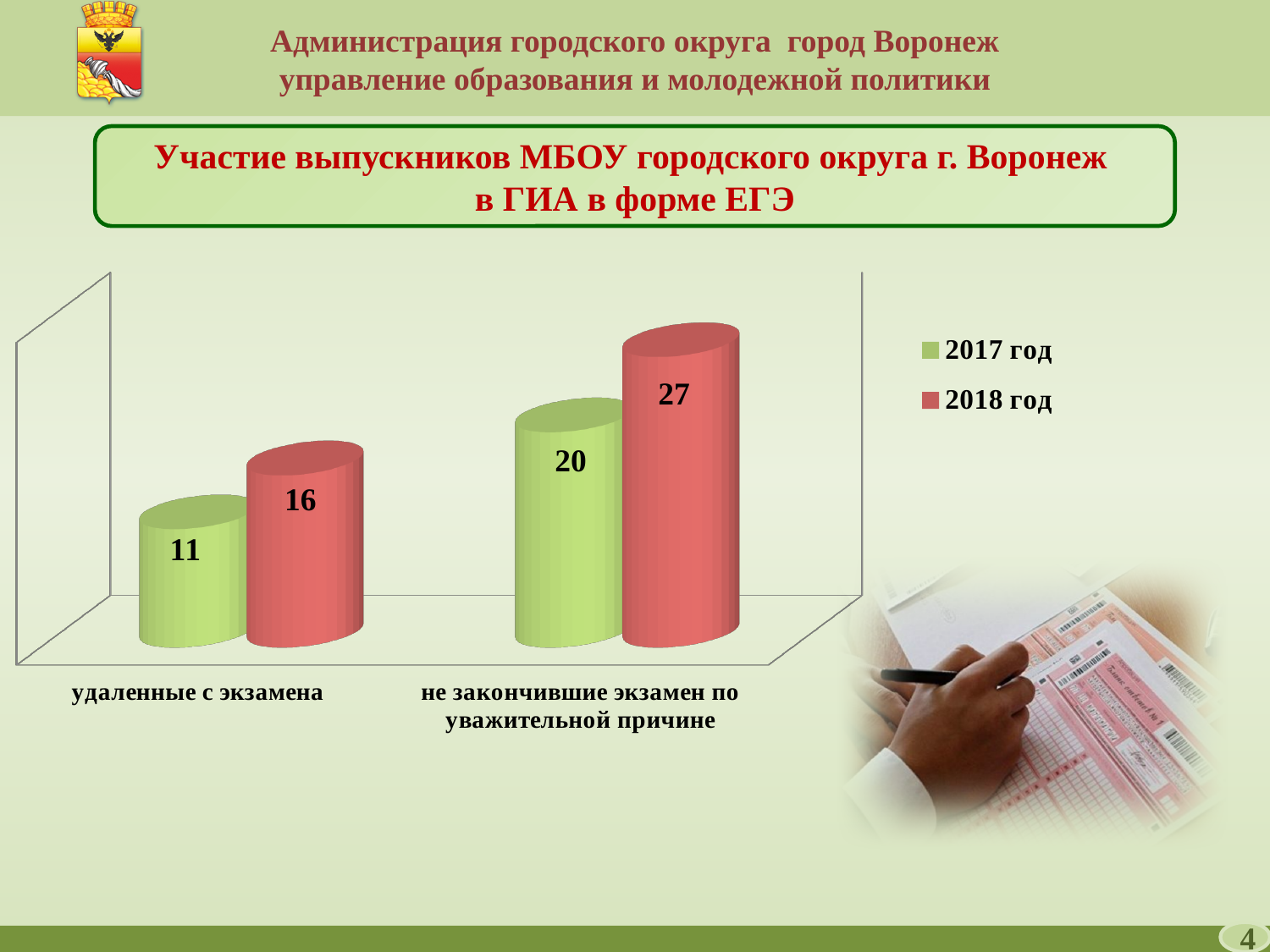
What is the value for 2018 год in the category 'не закончившие экзамен по уважительной причине'? 27 What kind of chart is shown on the slide? bar chart How many series does the legend list? 2 What is the difference between the 2018 год and 2017 год values for 'не закончившие экзамен по уважительной причине'? 7 Which category has the highest value for 2018 год? не закончившие экзамен по уважительной причине How many categories are shown on the x axis of the chart? 2 What is the difference between the 2018 год and 2017 год values for 'удаленные с экзамена'? 5 Which category has the lowest value for 2017 год? удаленные с экзамена What is the value for 2017 год in the category 'не закончившие экзамен по уважительной причине'? 20 Which is larger: the 2017 год value for 'не закончившие экзамен по уважительной причине' or the 2018 год value for 'удаленные с экзамена'? 2017 год value for 'не закончившие экзамен по уважительной причине' What is the value for 2017 год in the category 'удаленные с экзамена'? 11 What is the value for 2018 год in the category 'удаленные с экзамена'? 16